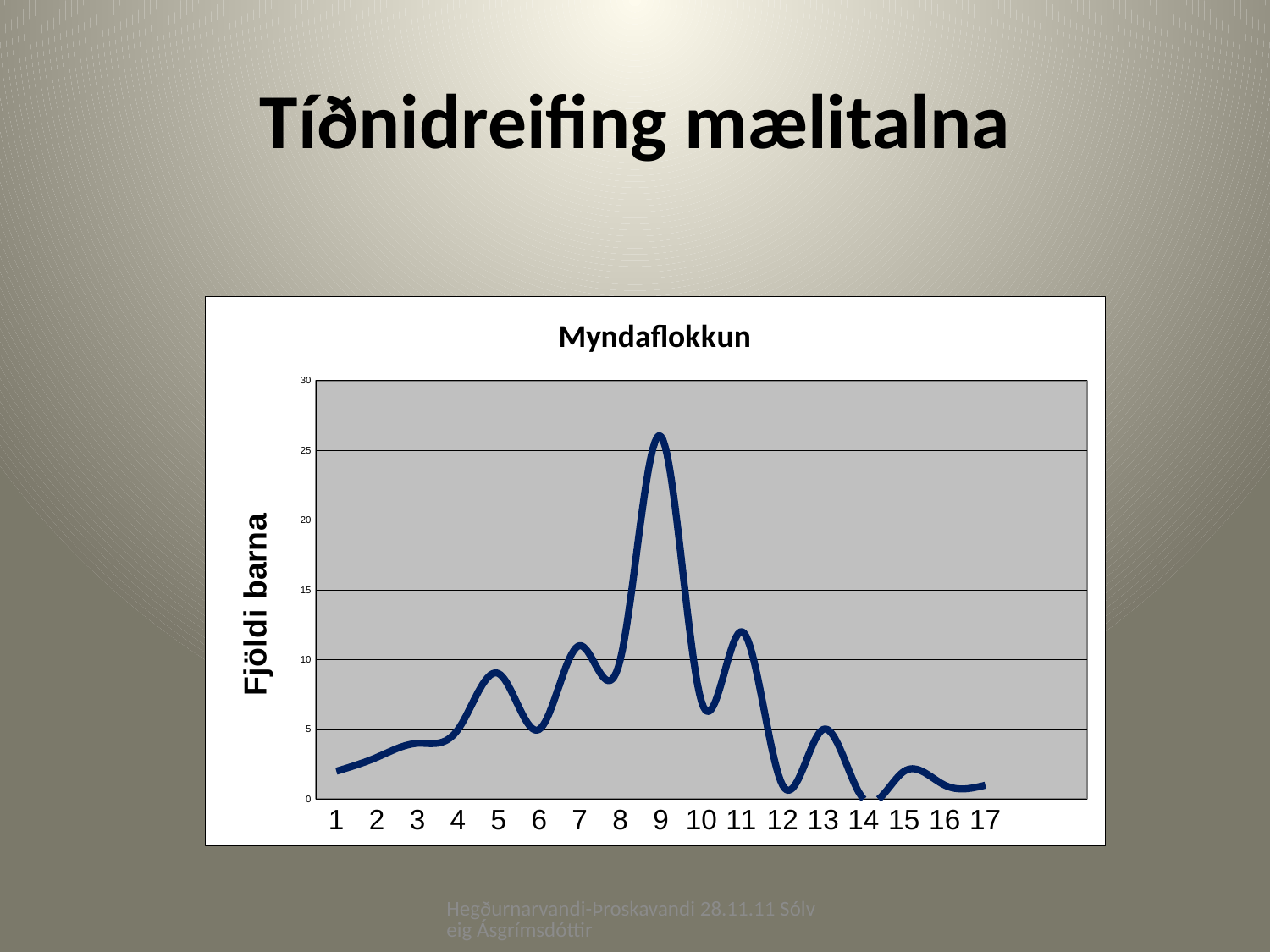
Is the value for category 9 greater or less than 25? greater What is the label on the vertical axis of the chart? Fjöldi barna How many categories are shown along the x axis of the chart? 17 Is the value for category 11 greater or less than 10? greater Which has a larger value, category 13 or category 11? 11 Which has a larger value, category 7 or category 10? 7 What is the title of the chart? Myndaflokkun Is the value for category 5 greater or less than 10? less What kind of chart is shown on the slide? line chart Which category has the highest value in the chart? 9